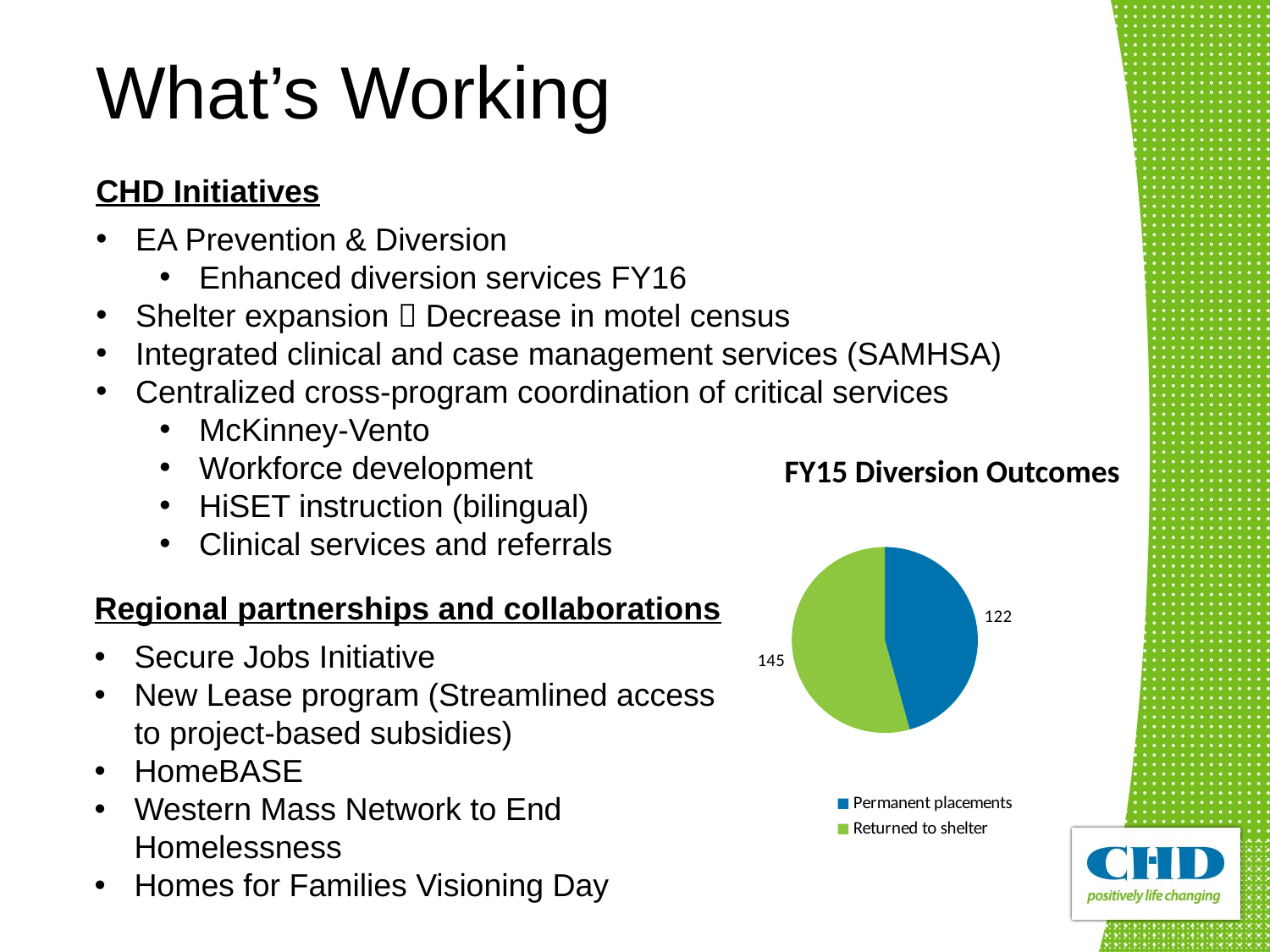
How many slices does the pie chart have? 2 Which category has the smallest slice of the pie? Permanent placements How many entries does the chart's legend list? 2 Which category has the largest slice of the pie? Returned to shelter What is the title of the chart? FY15 Diversion Outcomes Which is larger, Permanent placements or Returned to shelter? Returned to shelter Which colour represents Permanent placements in the pie chart? Blue What kind of chart is shown on the slide? Pie chart What is the value for Permanent placements? 122 What is the value for Returned to shelter? 145 What is the total of the two slices in the pie chart? 267 What is the difference between Returned to shelter and Permanent placements? 23